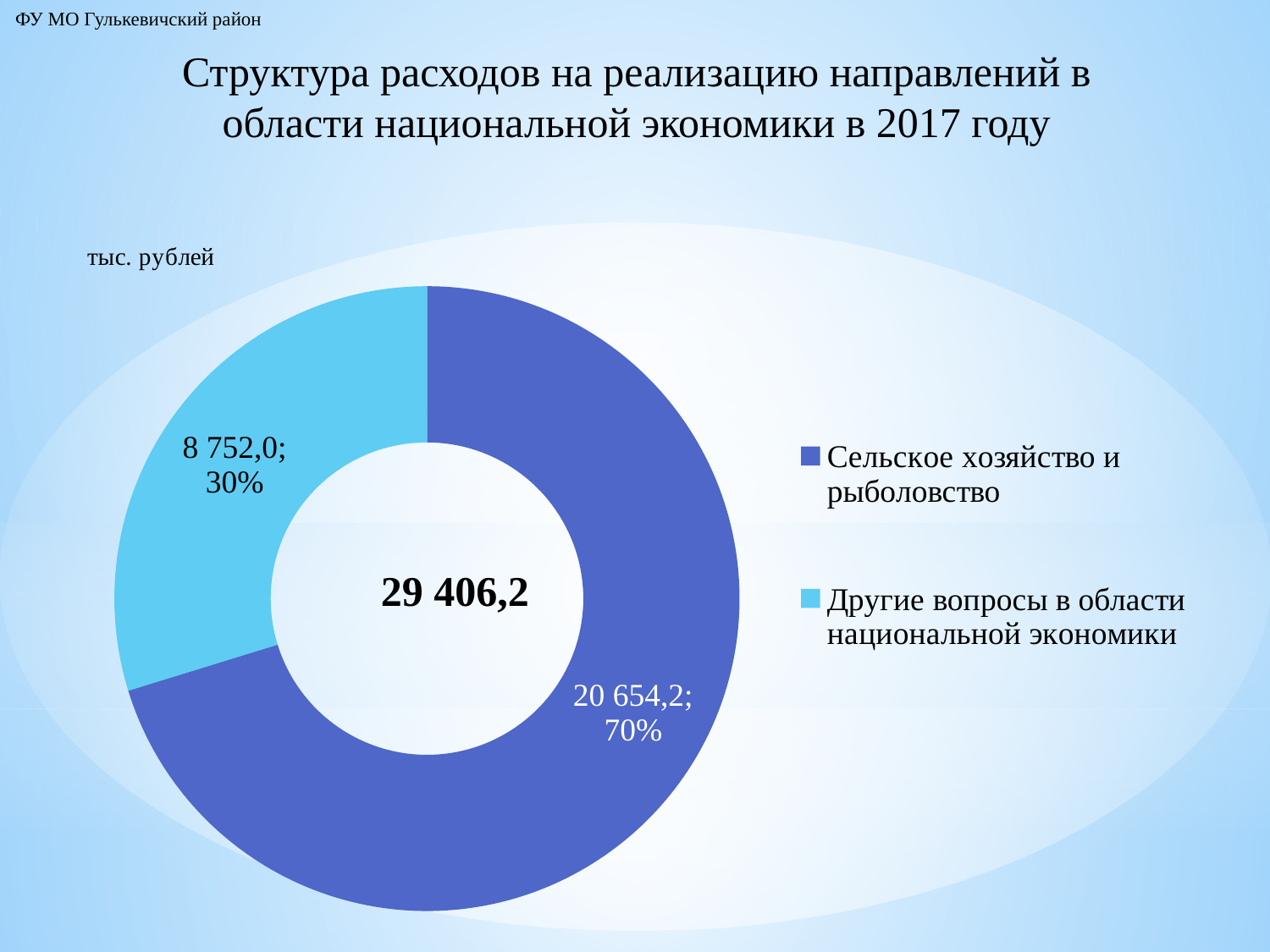
What is the value for Сельское хозяйство и рыболовство? 20 654,2 Which category has the smallest value? Другие вопросы в области национальной экономики What share of the chart does Сельское хозяйство и рыболовство represent? 70% How many categories does the chart show? 2 What is the value for Другие вопросы в области национальной экономики? 8 752,0 Which category has the largest value? Сельское хозяйство и рыболовство What share of the chart does Другие вопросы в области национальной экономики represent? 30% What total value is shown in the centre of the chart? 29 406,2 What unit is indicated for the values on the chart? тыс. рублей What kind of chart is shown on the slide? Doughnut (pie) chart What is the difference between the values for Сельское хозяйство и рыболовство and Другие вопросы в области национальной экономики? 11 902,2 Which is larger: Сельское хозяйство и рыболовство or Другие вопросы в области национальной экономики? Сельское хозяйство и рыболовство